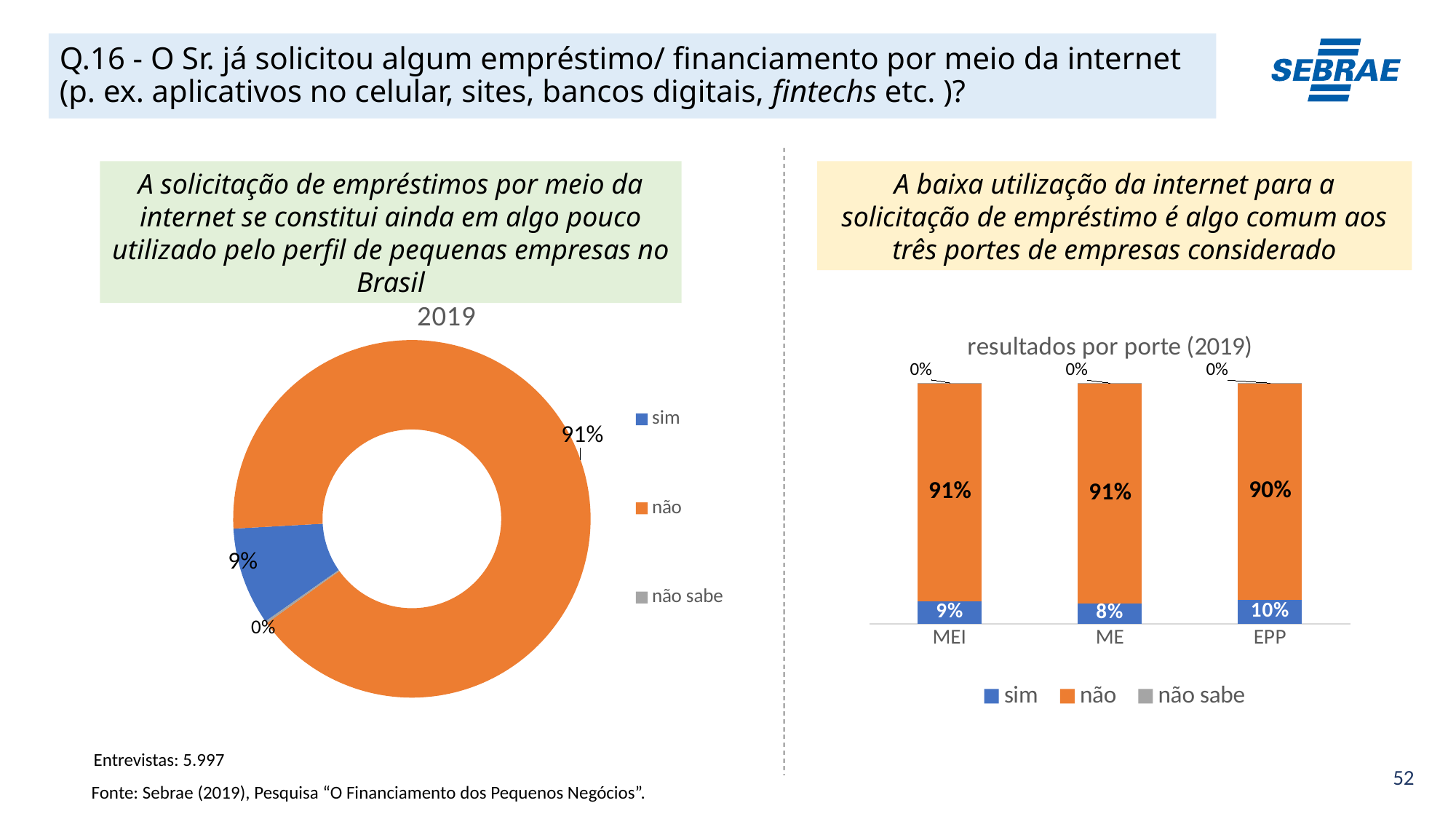
In the '2019' doughnut chart on the left, what share of respondents answered 'não'? 91% In the 'resultados por porte (2019)' chart on the right, which porte has the highest 'sim' value? EPP In the '2019' doughnut chart on the left, what share is shown for 'não sabe'? 0% In the 'resultados por porte (2019)' chart on the right, how many portes (categories) are shown on the x axis? 3 In the '2019' doughnut chart on the left, what share of respondents answered 'sim'? 9% What kind of chart is the 'resultados por porte (2019)' chart on the right? Stacked bar chart What kind of chart is the '2019' chart on the left? Doughnut (pie) chart In the '2019' doughnut chart on the left, how many categories does the legend list? 3 In the 'resultados por porte (2019)' chart on the right, what is the 'não' value for ME? 91% In the 'resultados por porte (2019)' chart on the right, what is the 'sim' value for EPP? 10% In the '2019' doughnut chart on the left, which category has the largest share? não In the 'resultados por porte (2019)' chart on the right, what is the difference between the 'sim' values for EPP and ME? 2%